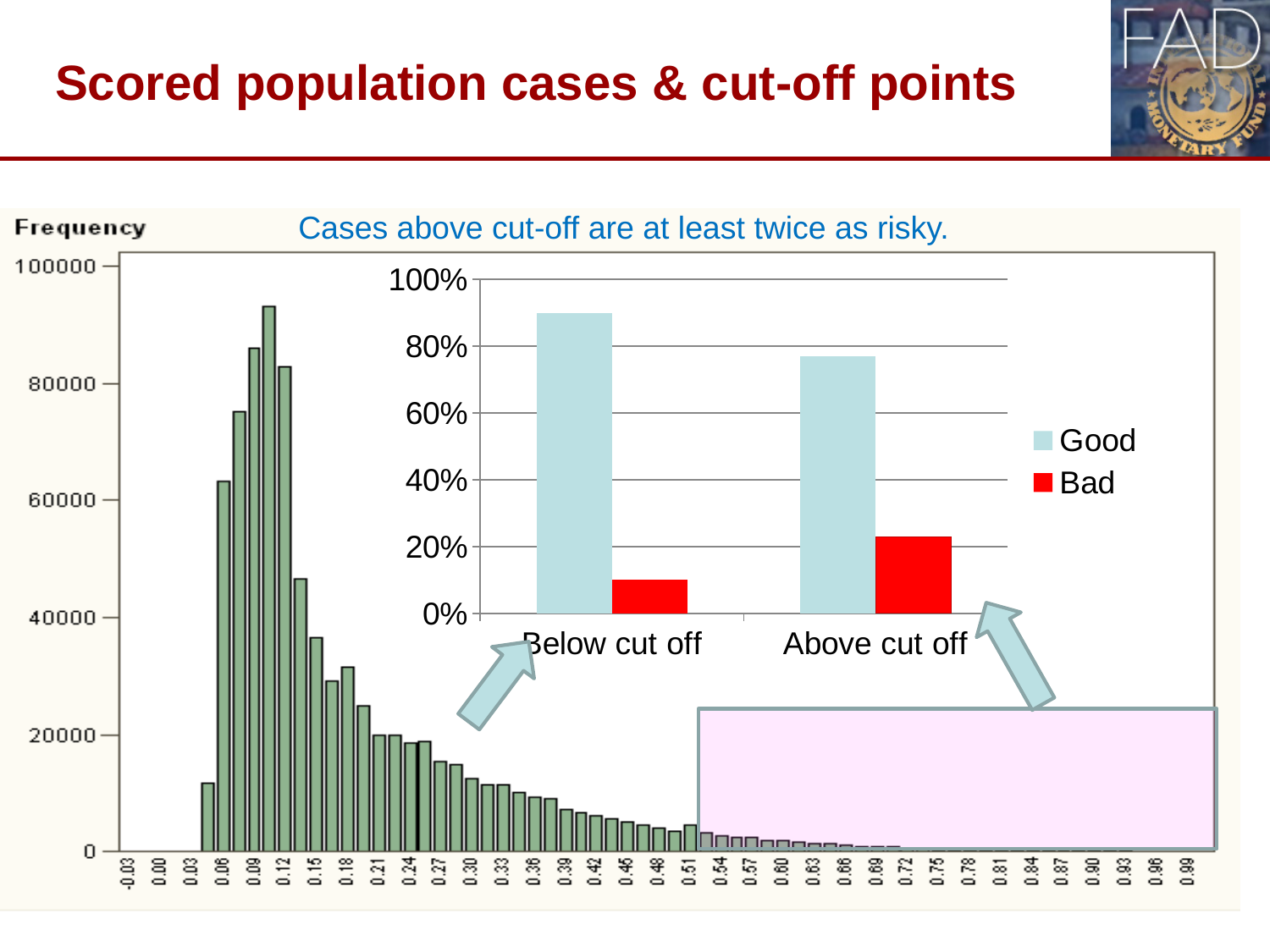
In the inset bar chart, which category has the larger Bad value, Below cut off or Above cut off? Above cut off In the Frequency histogram, is the frequency for the 0.12 bin greater or less than 80000? greater In the inset bar chart, how many series does the legend list? 2 In the inset bar chart, is the Good value for Below cut off greater or less than 80%? greater In the inset bar chart, is the Bad value for Below cut off greater or less than 20%? less What kind of chart is the inset chart with the Good and Bad series? bar chart In the inset bar chart, which category has the larger Good value, Below cut off or Above cut off? Below cut off In the Frequency histogram, do the frequencies rise or fall along the x axis from 0.12 to 0.51? fall In the inset bar chart, what are the two legend entries? Good, Bad In the inset bar chart, how many categories are shown on the x axis? 2